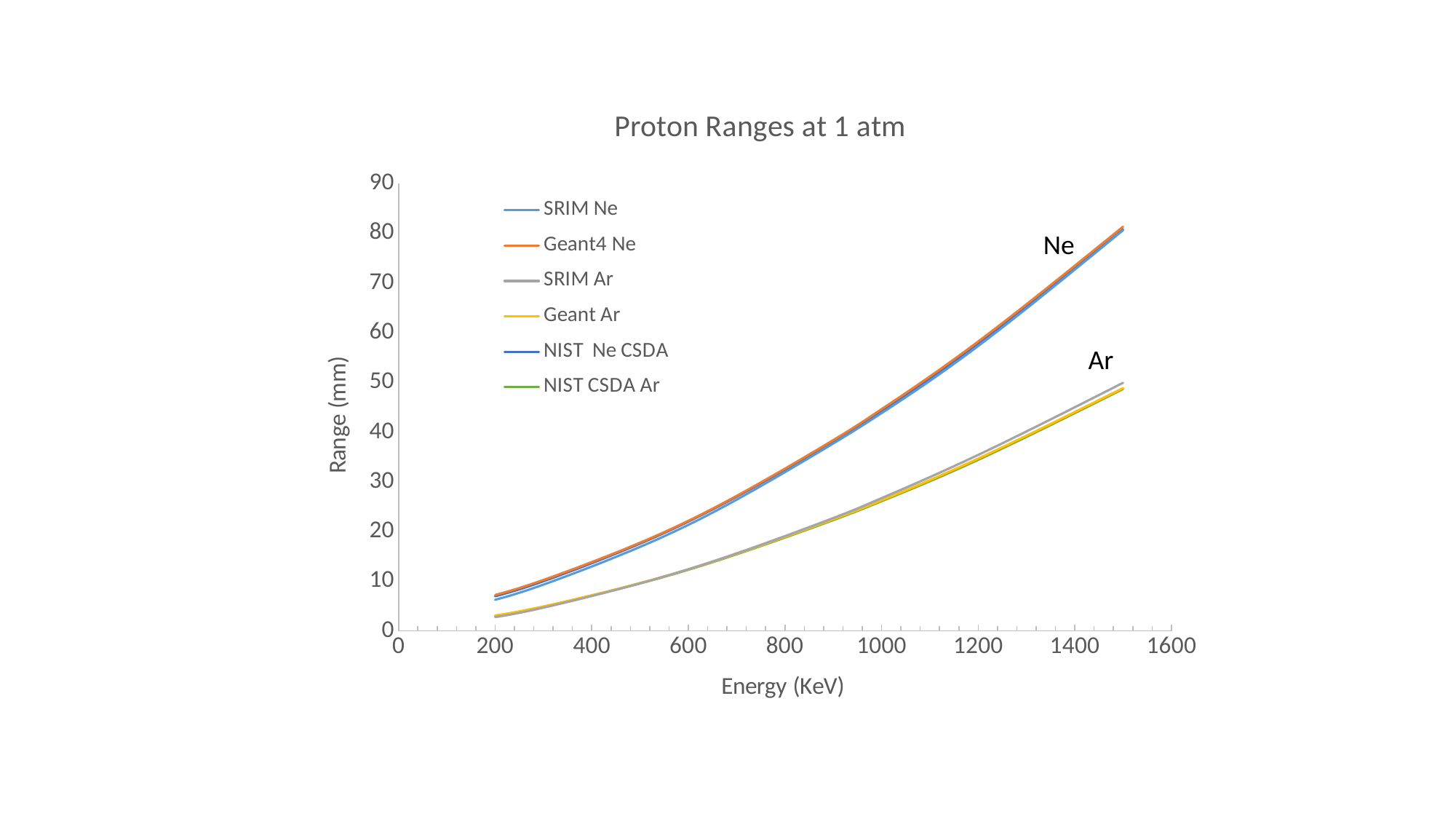
At 1400 KeV, which gas has the larger proton range, Ne or Ar? Ne What is the title of the chart? Proton Ranges at 1 atm Is the range for Ne at 1200 KeV greater or less than 50 mm? greater What is the label of the y axis? Range (mm) How many series does the legend list? 6 Is the range for Ar at 1000 KeV greater or less than 20 mm? greater What kind of chart is shown on the slide? Line chart Is the range for Ar at 1400 KeV greater or less than 50 mm? less Which group of curves reaches the highest range at 1500 KeV, Ne or Ar? Ne Do the range values rise or fall as energy increases along the x axis? Rise